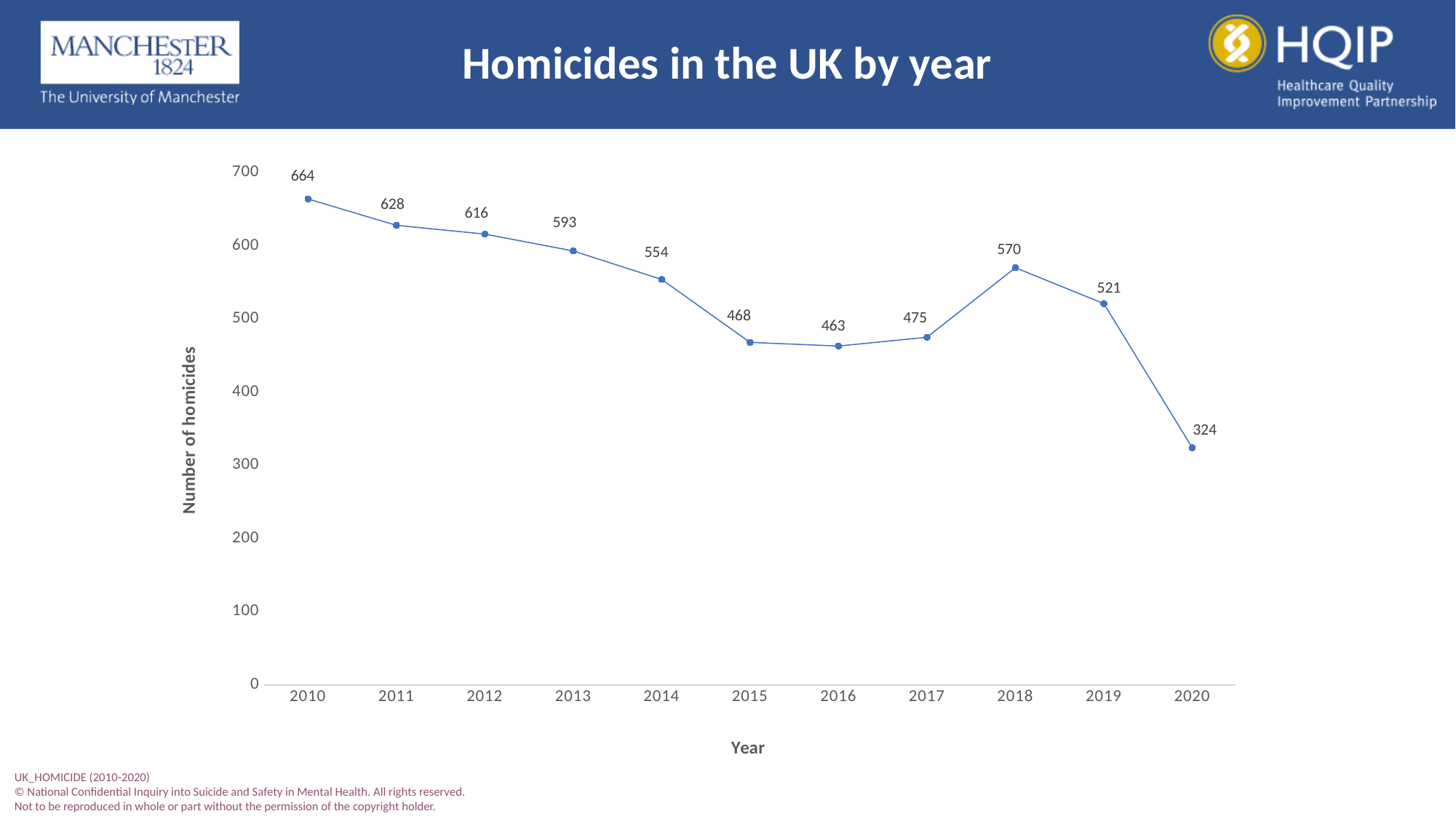
How many years are plotted on the chart? 11 Which year has more homicides, 2014 or 2018? 2014 What is the number of homicides in 2016? 463 Which year has the lowest number of homicides? 2020 What is the number of homicides in 2020? 324 What is the label of the y axis? Number of homicides What is the difference in the number of homicides between 2018 and 2019? 49 Which year has the highest number of homicides? 2010 What is the difference in the number of homicides between 2010 and 2020? 340 What kind of chart is shown on the slide? Line chart Is the value for 2019 greater or less than 500? greater What is the number of homicides in 2010? 664